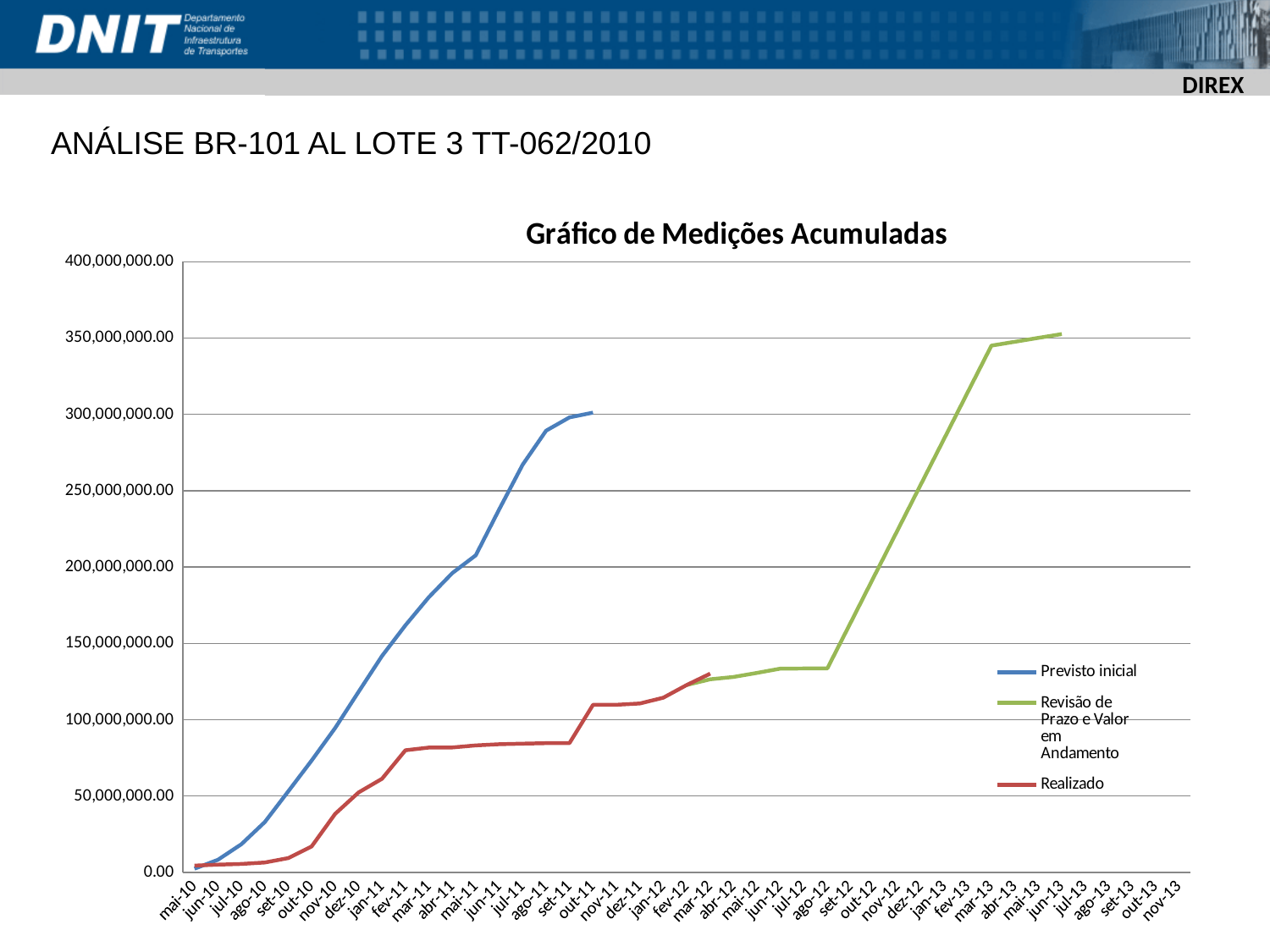
Is the value for Realizado at set-11 greater or less than 100,000,000.00? less Which colour is used for the Realizado series? red How many series does the legend list? 3 Which series reaches the highest value on the chart? Revisão de Prazo e Valor em Andamento What kind of chart is shown on the slide? line chart Is the value for Revisão de Prazo e Valor em Andamento at mar-13 greater or less than 300,000,000.00? greater Is the value for Previsto inicial at ago-11 greater or less than 250,000,000.00? greater What is the title of the chart? Gráfico de Medições Acumuladas At set-11, which series has the larger value, Previsto inicial or Realizado? Previsto inicial Does the Previsto inicial series rise or fall from mai-10 to out-11? rise